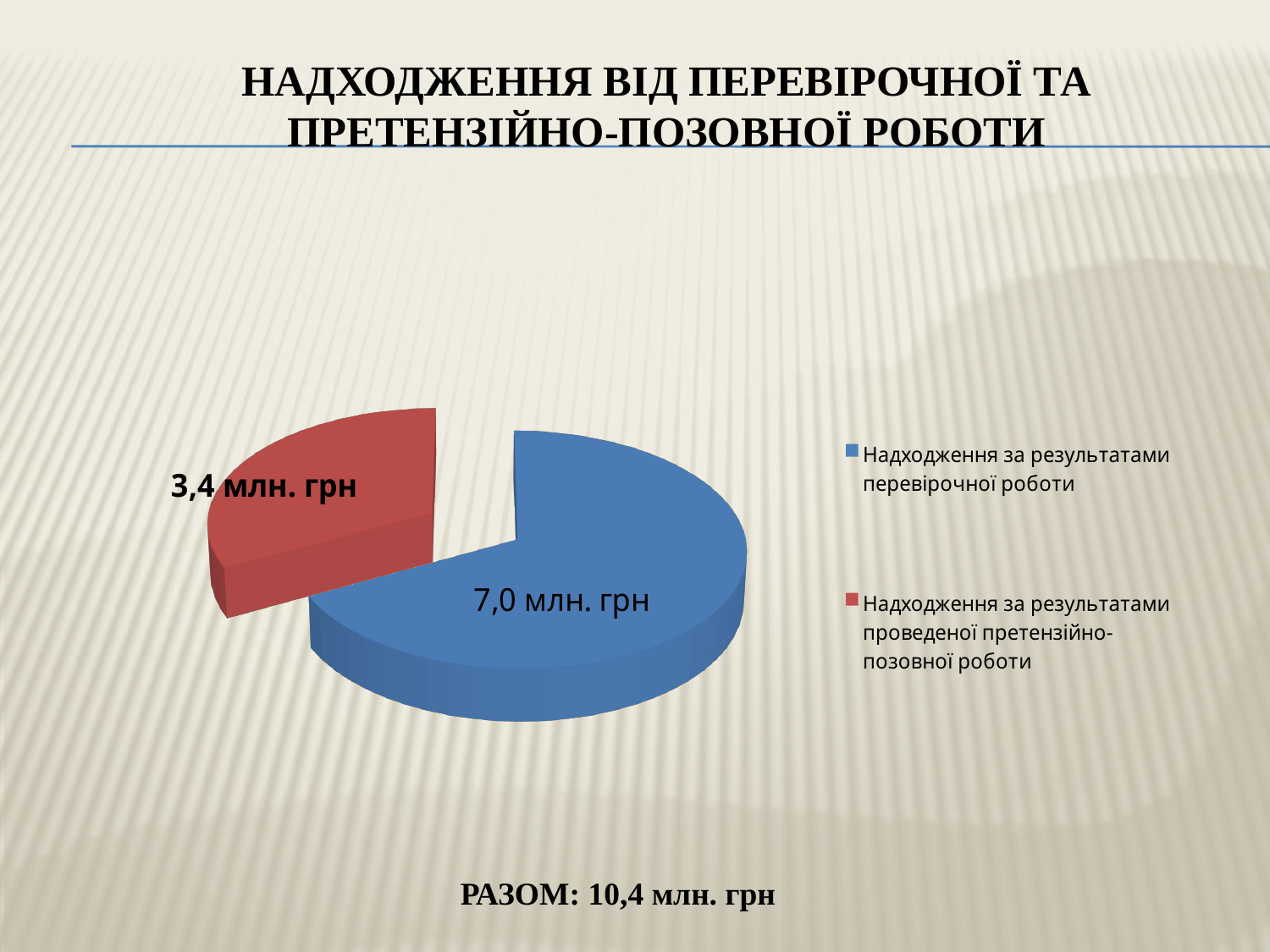
What is the value of the slice for 'Надходження за результатами перевірочної роботи'? 7,0 млн. грн Which is larger: the value for перевірочної роботи or the value for претензійно-позовної роботи? перевірочної роботи What is the value of the slice for 'Надходження за результатами проведеної претензійно-позовної роботи'? 3,4 млн. грн Which category has the largest slice of the pie? Надходження за результатами перевірочної роботи What colour is the slice for 'Надходження за результатами проведеної претензійно-позовної роботи'? red What type of chart is shown on the slide? pie chart How many slices does the pie chart have? 2 What is the difference between the value for перевірочної роботи and the value for претензійно-позовної роботи? 3,6 млн. грн What is the total of the two slices, as stated on the slide? 10,4 млн. грн How many entries does the legend list? 2 Does the slice for перевірочної роботи represent more or less than half of the pie? more Which category has the smallest slice of the pie? Надходження за результатами проведеної претензійно-позовної роботи